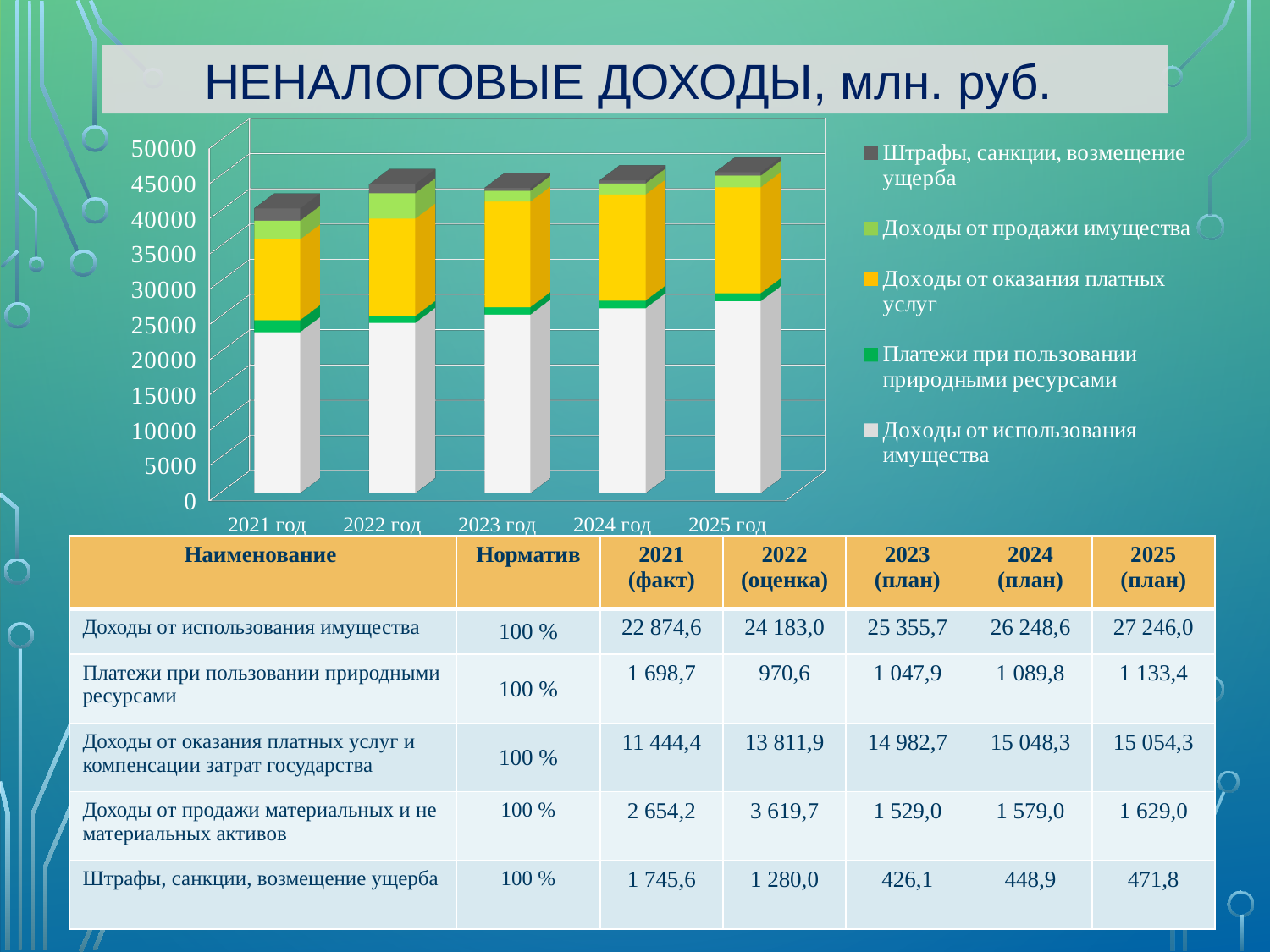
How many series does the chart legend list? 5 Is the total height of the 2021 год bar greater or less than 45000? less How many years (categories) are shown on the x axis of the chart? 5 According to the table, what is the value of «Штрафы, санкции, возмещение ущерба» for 2023 (план)? 426,1 What kind of chart is shown on the slide? Stacked bar chart According to the table, what is the value of «Доходы от оказания платных услуг и компенсации затрат государства» for 2022 (оценка)? 13 811,9 In which year is «Штрафы, санкции, возмещение ущерба» lowest? 2023 Does the «Доходы от использования имущества» segment rise or fall from 2021 год to 2025 год? Rises Which colour represents «Доходы от оказания платных услуг» in the chart? Yellow Is the «Доходы от использования имущества» segment for 2025 год greater or less than 25000? greater What is the title of the chart? НЕНАЛОГОВЫЕ ДОХОДЫ, млн. руб. Which is larger for «Платежи при пользовании природными ресурсами»: the 2021 value or the 2022 value? 2021